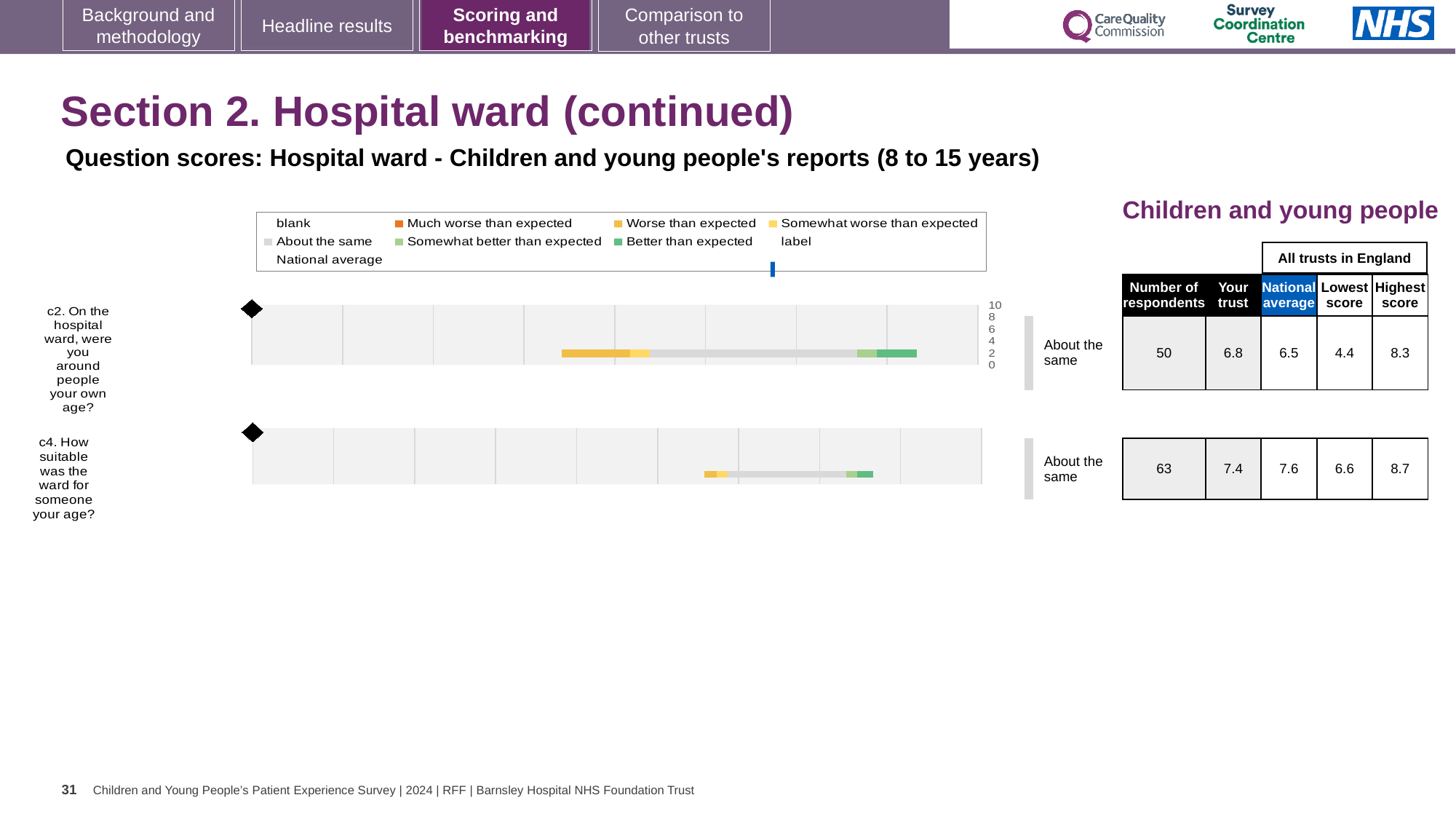
What is the national average score for question c4 (How suitable was the ward for someone your age?)? 7.6 What is the highest score across all trusts in England for question c2? 8.3 What is the lowest score across all trusts in England for question c4? 6.6 What is the difference between the highest and lowest scores for question c2? 3.9 How many questions (chart rows) are plotted on the slide? 2 What is the 'Your trust' score for question c2 (On the hospital ward, were you around people your own age?)? 6.8 For question c4, is the trust's score higher or lower than the national average? lower What benchmark category is shown for both question c2 and question c4? About the same What is the difference in the number of respondents between question c4 and question c2? 13 How many respondents answered question c4? 63 For question c2, is the trust's score higher or lower than the national average? higher What kind of chart is used to show the question scores for c2 and c4? bar chart